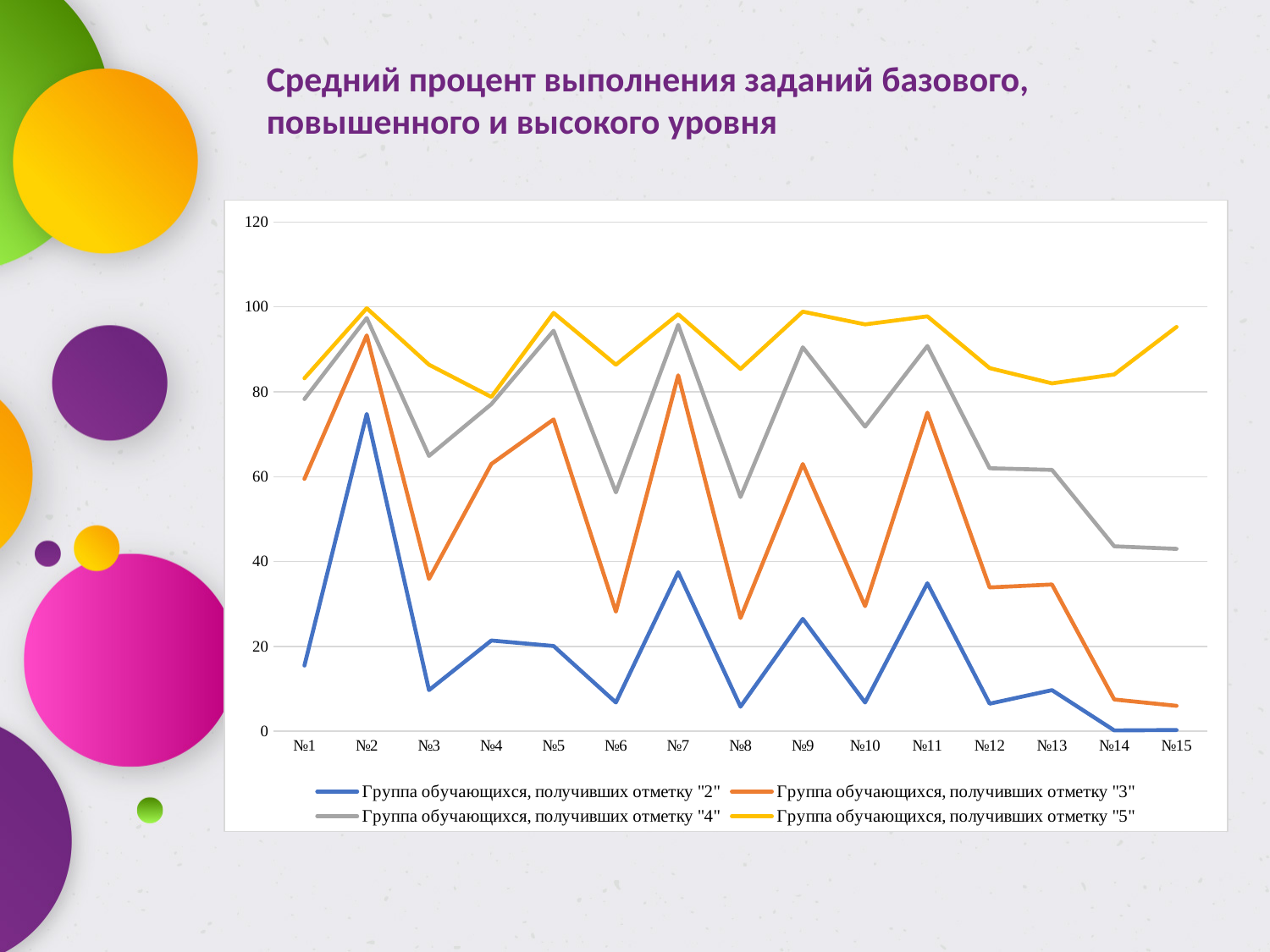
For which task does the series 'Группа обучающихся, получивших отметку "2"' reach its highest value? №2 For which task does the series 'Группа обучающихся, получивших отметку "3"' reach its highest value? №2 Is the value for №14 in the series 'Группа обучающихся, получивших отметку "4"' greater or less than 40? greater Is the value for №3 in the series 'Группа обучающихся, получивших отметку "3"' greater or less than 40? less What kind of chart is shown on the slide? line chart In the series 'Группа обучающихся, получивших отметку "4"', which is larger: the value for №6 or the value for №10? №10 Is the value for №10 in the series 'Группа обучающихся, получивших отметку "5"' greater or less than 80? greater What colour is the line for 'Группа обучающихся, получивших отметку "2"'? blue How many series does the legend list? 4 How many task categories are shown along the x axis? 15 Which series has the highest values across almost all tasks? Группа обучающихся, получивших отметку "5"